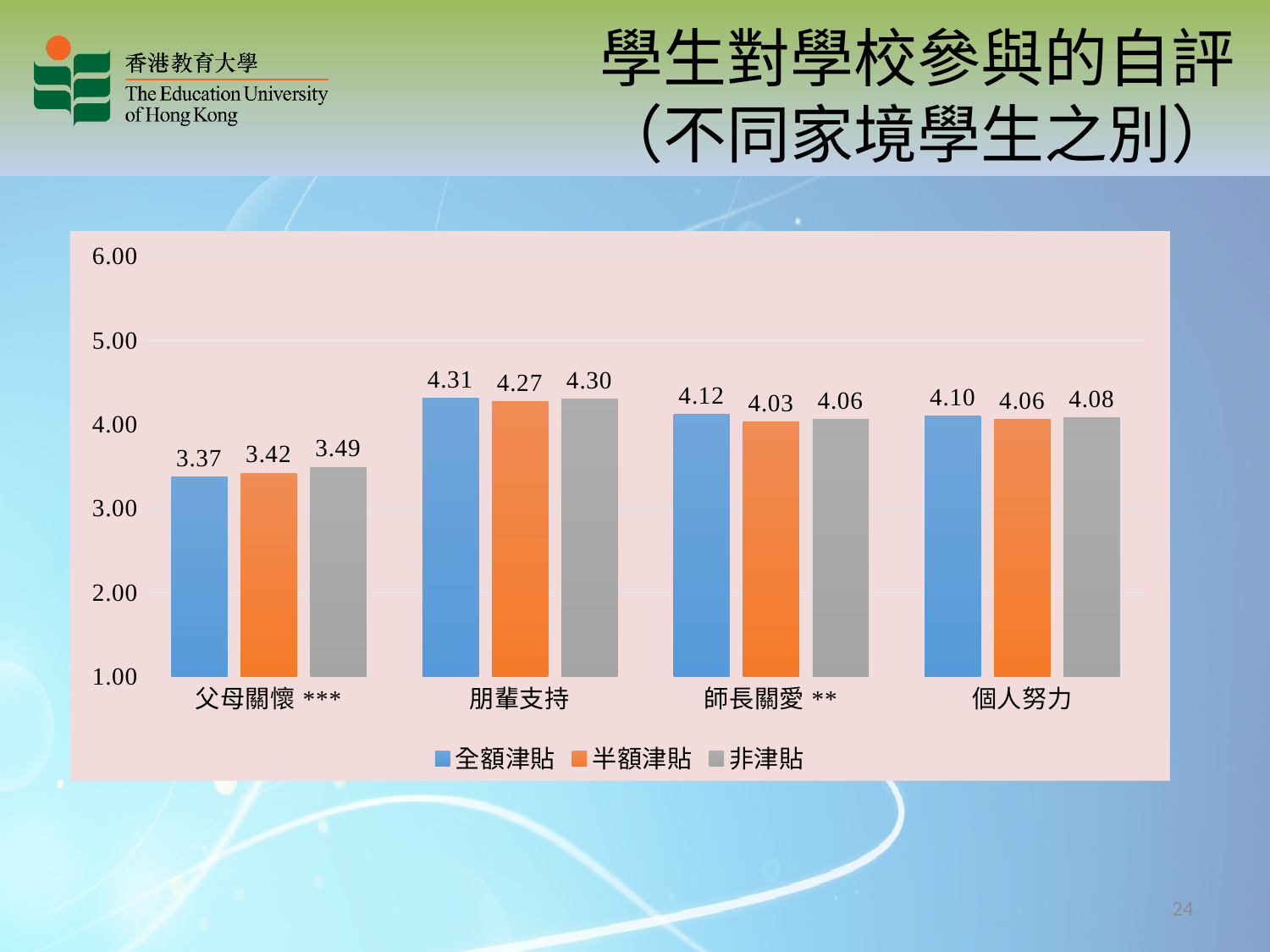
In the 朋輩支持 category, which is larger: the 全額津貼 value or the 半額津貼 value? 全額津貼 What is the difference between the 非津貼 and 全額津貼 values in the 父母關懷 *** category? 0.12 Which category has the lowest value for the 非津貼 series? 父母關懷 *** How many categories are shown on the x axis? 4 What is the value for 半額津貼 in the 師長關愛 ** category? 4.03 What is the value for 全額津貼 in the 個人努力 category? 4.10 What is the value for 非津貼 in the 朋輩支持 category? 4.30 What kind of chart is shown on the slide? bar chart What is the value for 全額津貼 in the 父母關懷 *** category? 3.37 How many series does the legend list? 3 Which category has the highest value for the 全額津貼 series? 朋輩支持 What colour are the bars for the 半額津貼 series? orange